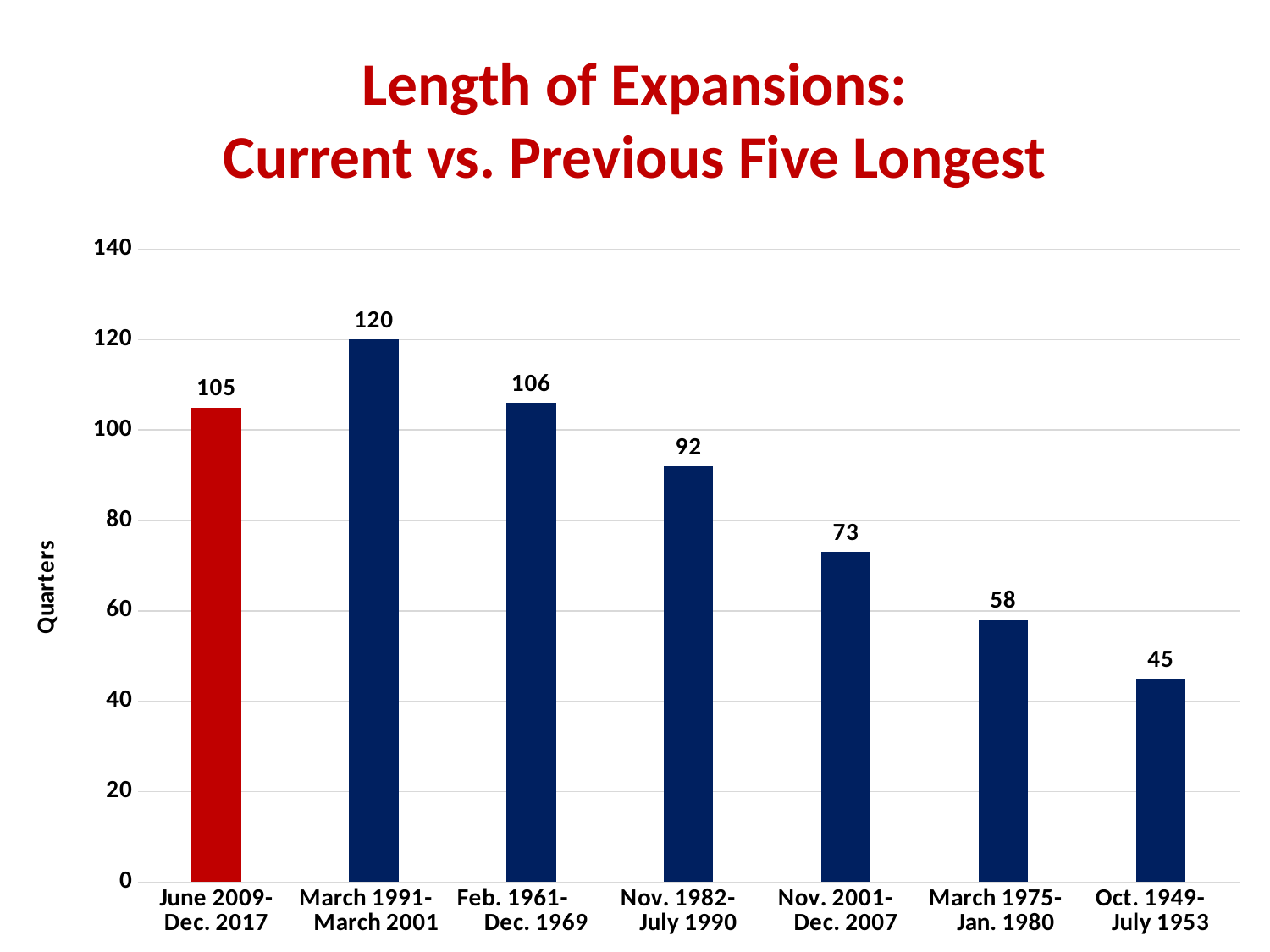
What is the label on the vertical axis? Quarters Which is larger, the value for Feb. 1961-Dec. 1969 or the value for June 2009-Dec. 2017? Feb. 1961-Dec. 1969 Which expansion has the lowest value? Oct. 1949-July 1953 What kind of chart is shown on the slide? bar chart How many expansions are shown on the chart? 7 What is the value for June 2009-Dec. 2017? 105 What is the value for Oct. 1949-July 1953? 45 What is the value for Nov. 1982-July 1990? 92 Is the value for Nov. 2001-Dec. 2007 greater or less than 80? less What is the difference between the values for March 1991-March 2001 and June 2009-Dec. 2017? 15 Which expansion has the highest value? March 1991-March 2001 What is the difference between the values for Nov. 2001-Dec. 2007 and March 1975-Jan. 1980? 15